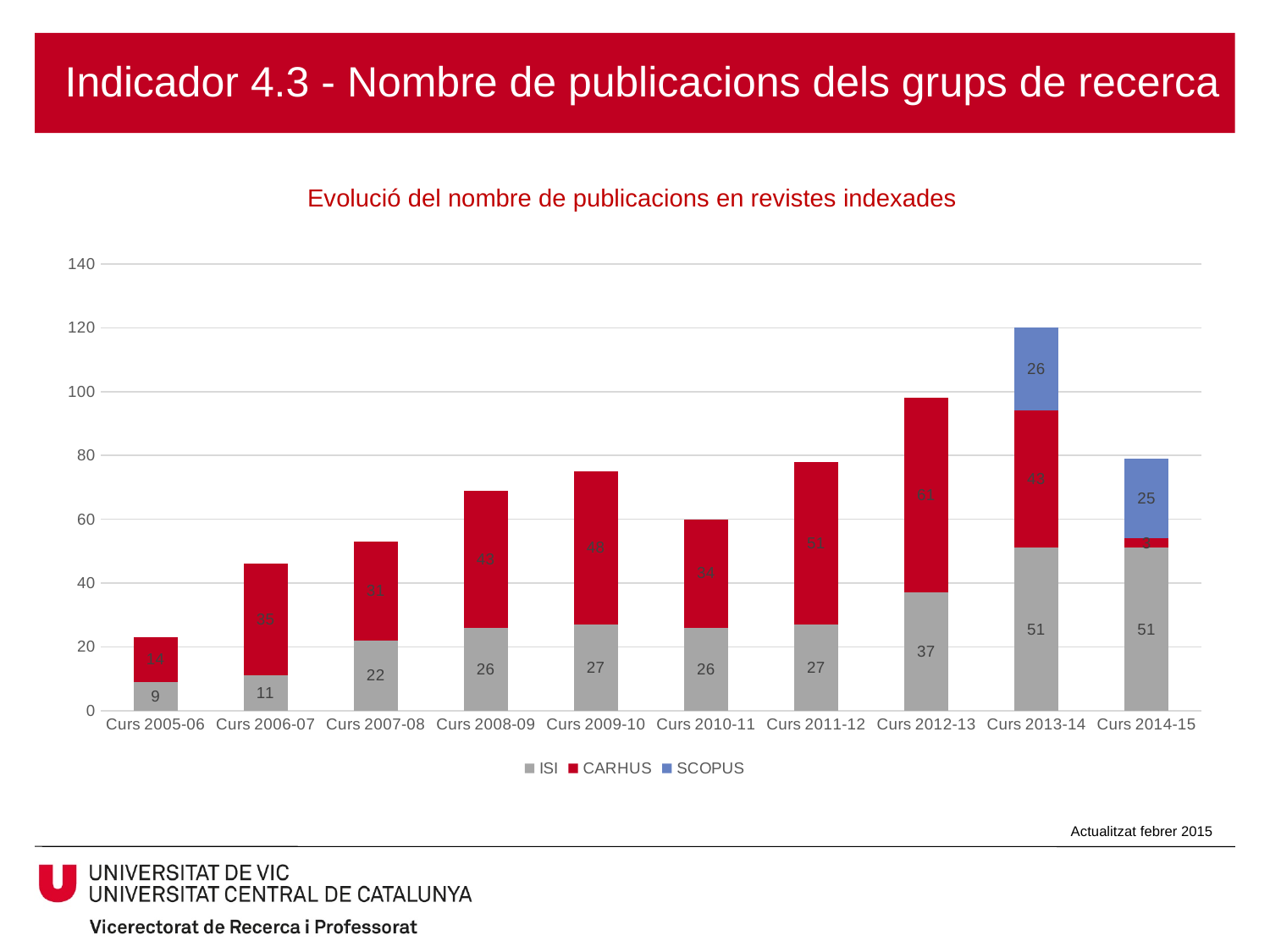
How many academic years (Curs) are shown on the x axis? 10 Which academic year has the lowest ISI value? Curs 2005-06 What kind of chart is shown on the slide? Stacked bar chart What is the SCOPUS value for Curs 2013-14? 26 Is the total height of the stacked bar for Curs 2013-14 greater or less than 100? greater How many series does the legend list? 3 Which has the larger ISI value, Curs 2007-08 or Curs 2008-09? Curs 2008-09 What is the ISI value for Curs 2005-06? 9 Which academic year has the tallest stacked bar overall? Curs 2013-14 What is the SCOPUS value for Curs 2014-15? 25 What is the difference between the ISI values for Curs 2013-14 and Curs 2012-13? 14 What is the ISI value for Curs 2012-13? 37